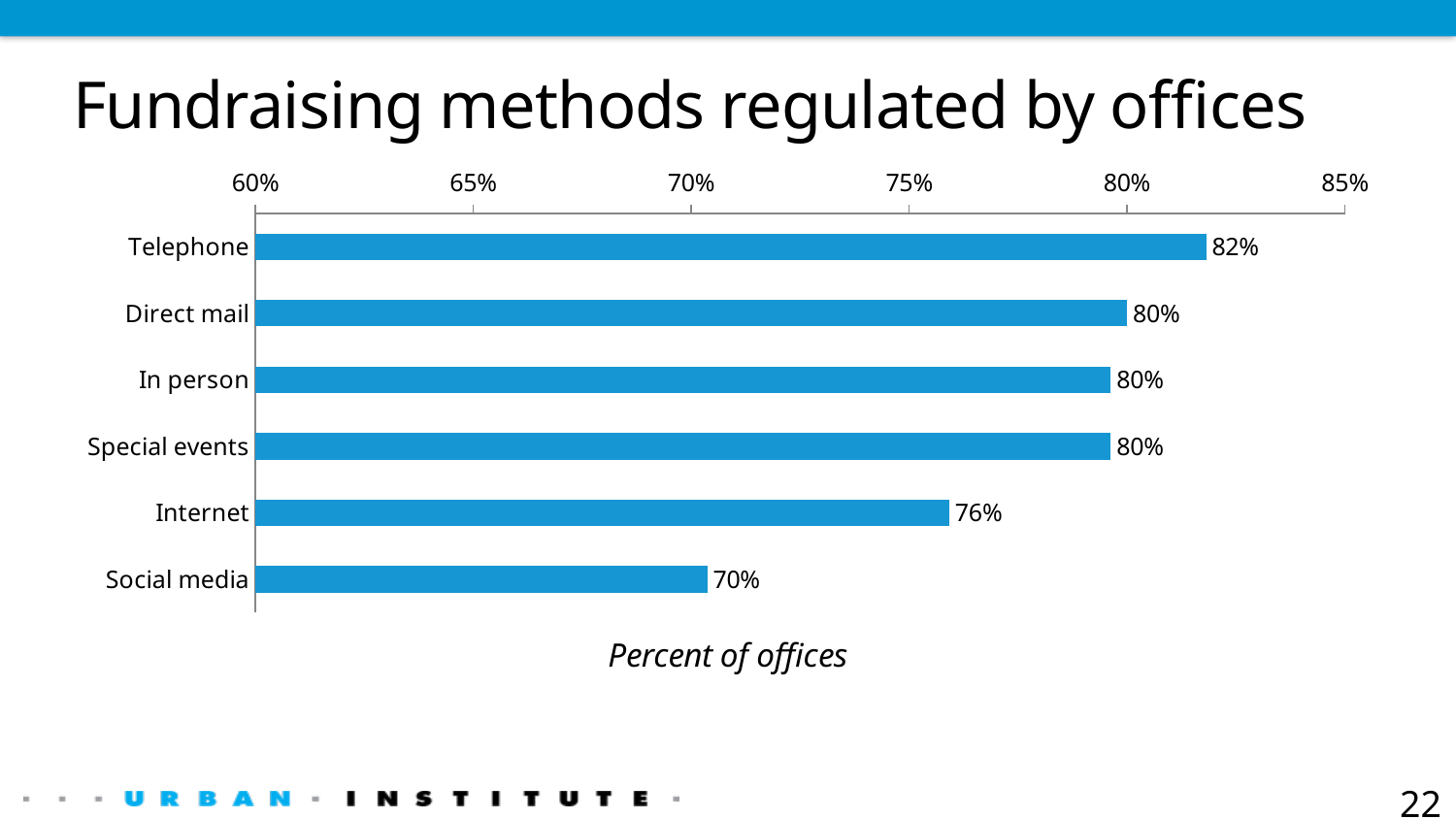
What is the value for Social media? 70% Is the value for Internet greater or less than 75%? greater How many fundraising methods are shown in the chart? 6 What is the axis label shown below the chart? Percent of offices Which fundraising method has the highest percent of offices regulating it? Telephone What is the difference between the values for Telephone and Social media? 12% What kind of chart is shown on the slide? Bar chart Which fundraising method has the lowest percent of offices regulating it? Social media What is the value for Internet? 76% Which is larger, the value for Internet or the value for Social media? Internet What is the difference between the values for Direct mail and Internet? 4% What percent of offices regulate telephone fundraising? 82%